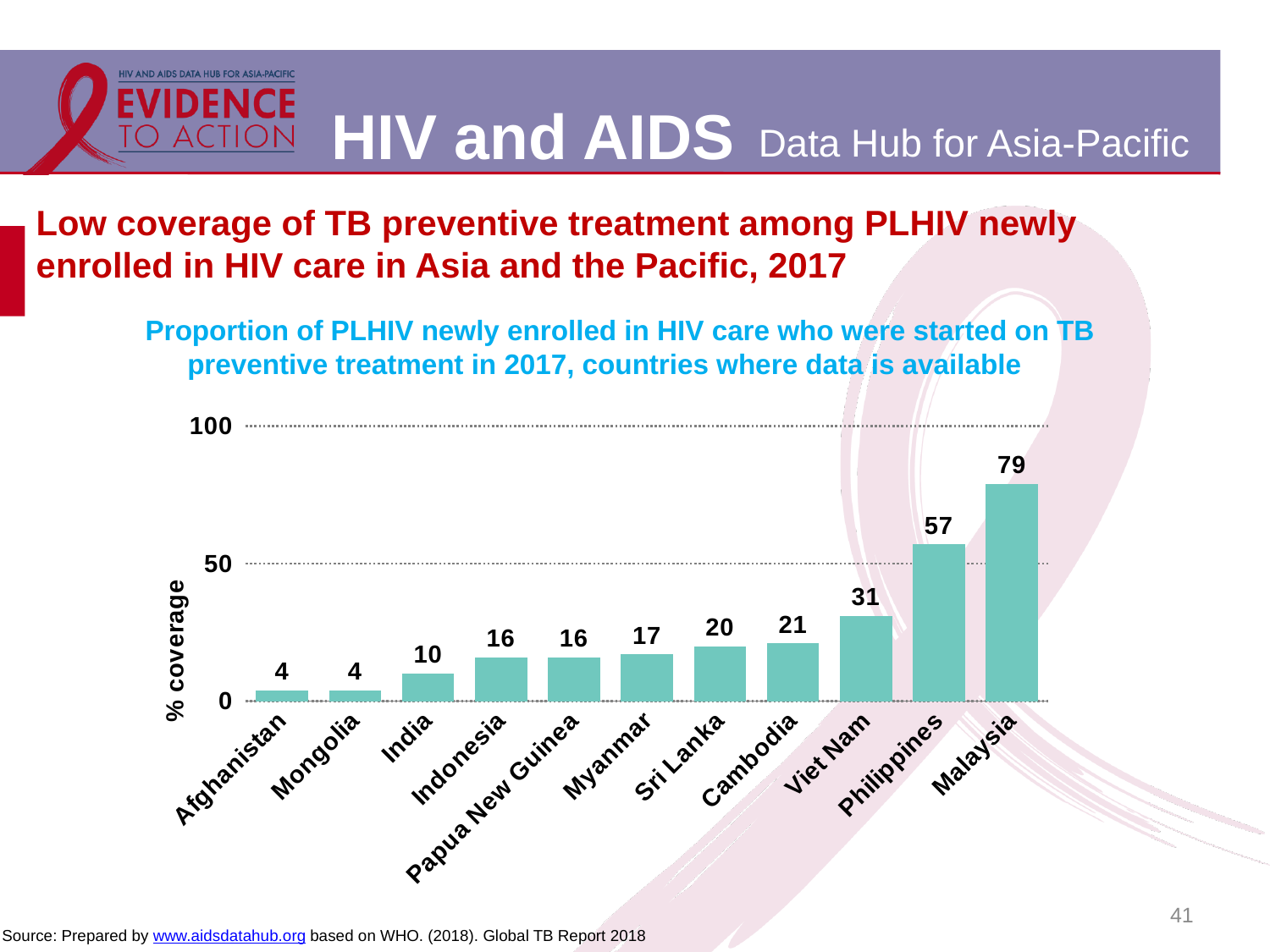
What is the % coverage value for Malaysia? 79 What kind of chart is shown on the slide? Bar chart Which has a higher % coverage, Sri Lanka or India? Sri Lanka What is the % coverage value for Cambodia? 21 Is the value for the Philippines greater or less than 50? greater Which country has the highest % coverage? Malaysia What is the difference in % coverage between Malaysia and the Philippines? 22 What is the label on the y axis of the chart? % coverage What is the % coverage value for Viet Nam? 31 Do the values rise or fall moving from left to right along the x axis? Rise How many countries are shown in the chart? 11 Which countries share the lowest % coverage value? Afghanistan and Mongolia